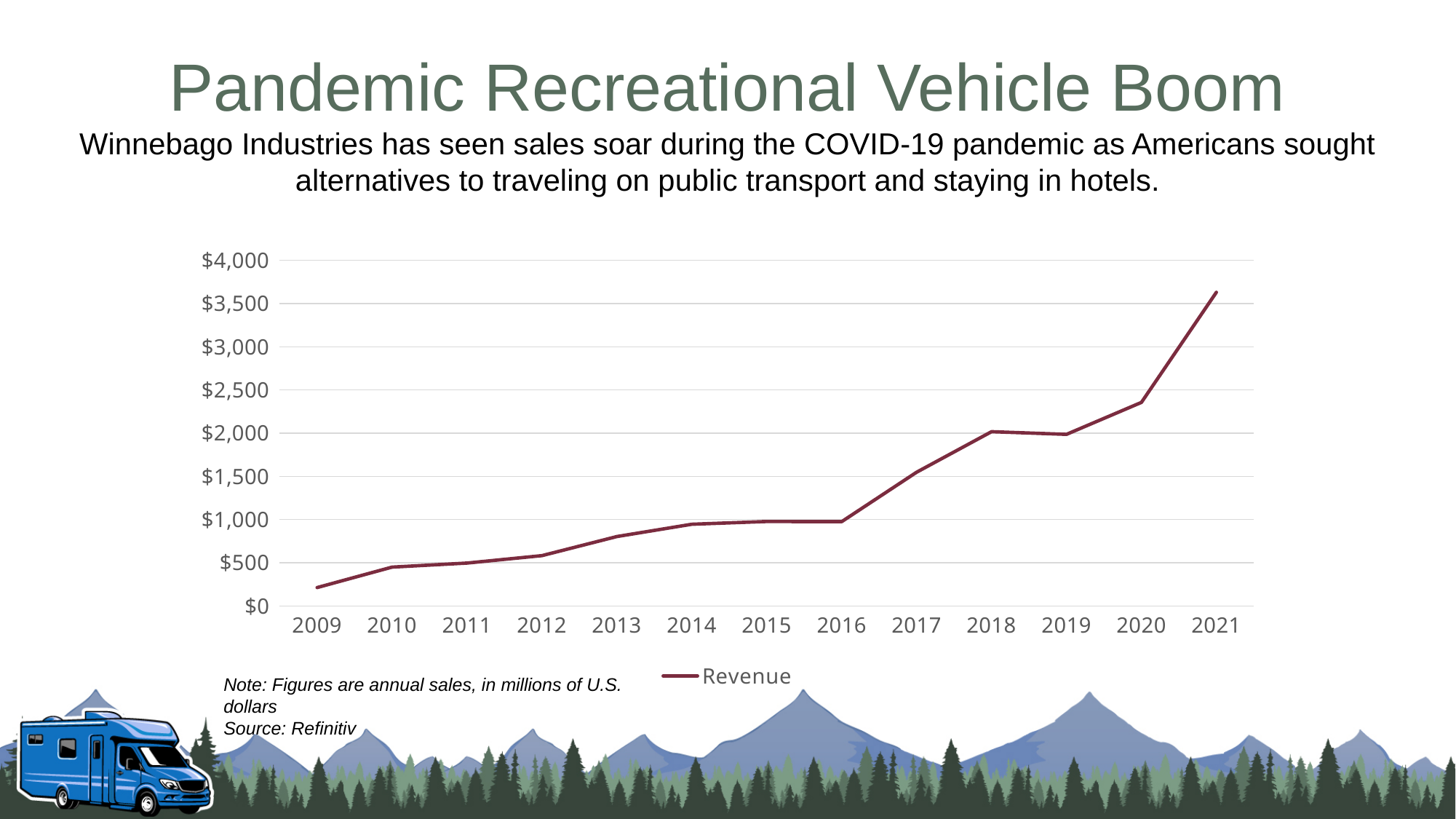
Is the revenue for 2020 greater or less than $2,000? greater Does revenue generally rise or fall from 2009 to 2021? Rise Is the revenue for 2021 greater or less than $3,500? greater How many series does the chart's legend list? 1 Is the revenue for 2013 greater or less than $1,000? less Which year has the highest revenue in the chart? 2021 What is the name of the series shown in the chart's legend? Revenue How many years are plotted on the x axis of the chart? 13 What kind of chart is shown on the slide? Line chart Which year has the lowest revenue in the chart? 2009 Which year has the larger revenue, 2017 or 2020? 2020